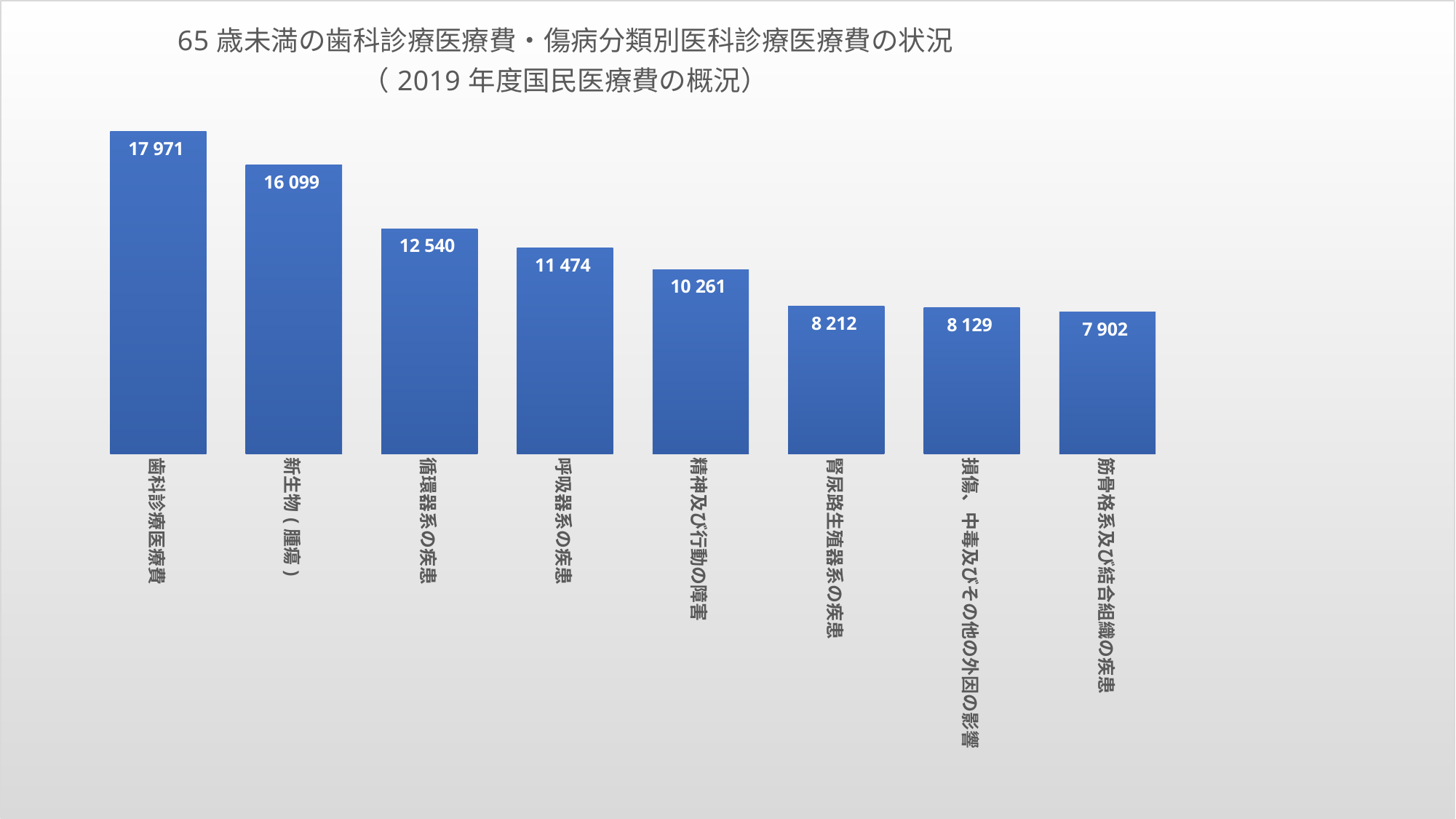
What is the difference between the values for 呼吸器系の疾患 and 腎尿路生殖器系の疾患? 3 262 Which is larger, the value for 循環器系の疾患 or the value for 呼吸器系の疾患? 循環器系の疾患 What is the value for 筋骨格系及び結合組織の疾患? 7 902 What is the difference between the values for 歯科診療医療費 and 新生物（腫瘍）? 1 872 What kind of chart is shown on the slide? Bar chart Which category has the lowest value? 筋骨格系及び結合組織の疾患 What is the value for 精神及び行動の障害? 10 261 How many categories are shown in the chart? 8 What is the value for 循環器系の疾患? 12 540 What is the value for 新生物（腫瘍）? 16 099 What is the value for 歯科診療医療費? 17 971 Which category has the highest value? 歯科診療医療費